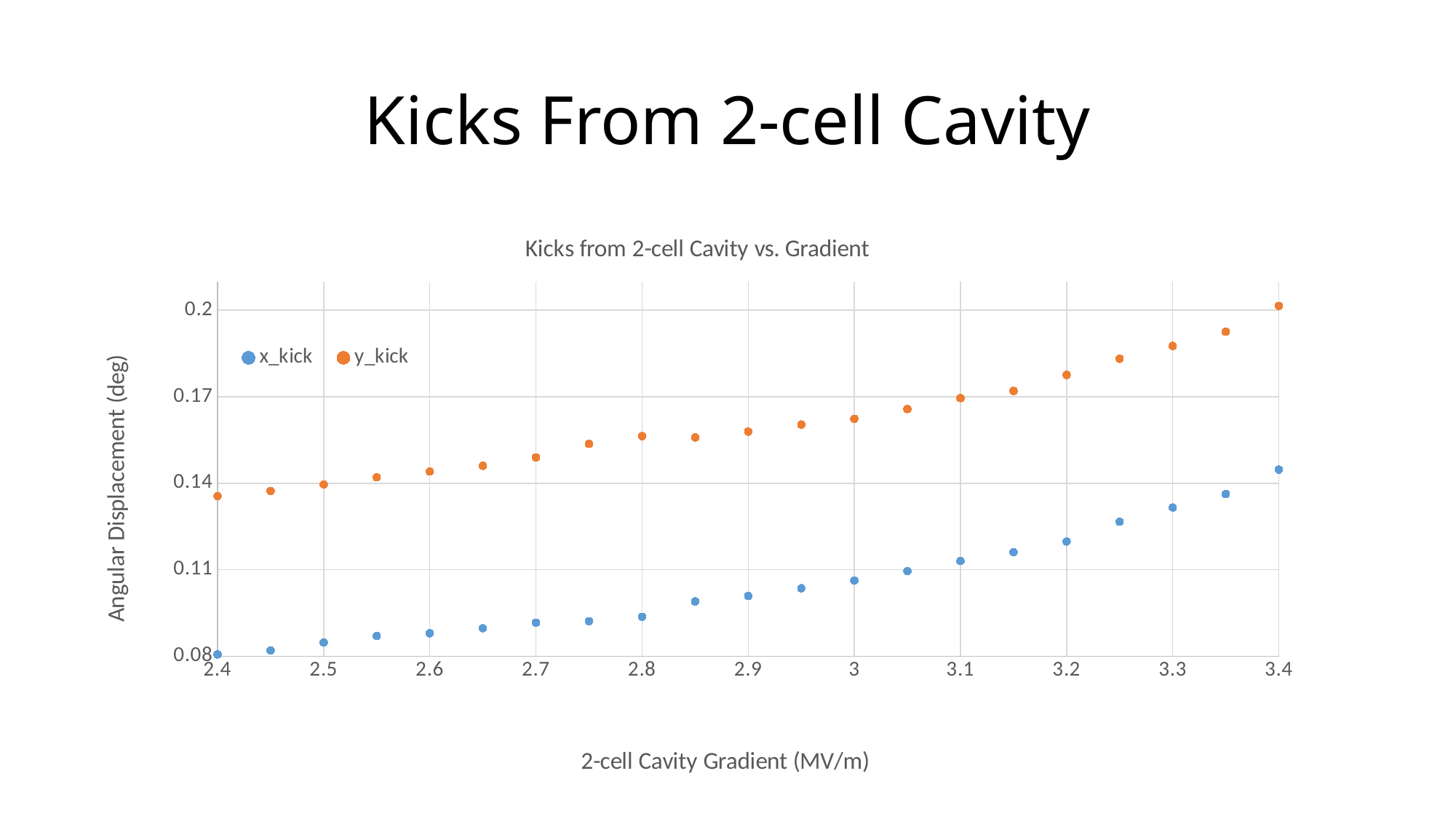
Is the y_kick value at a gradient of 2.4 MV/m greater or less than 0.14? less How many data points are plotted for the x_kick series? 21 Do the x_kick values rise or fall as the gradient increases along the x axis? rise What kind of chart is shown on the slide? scatter chart What is the label of the y axis? Angular Displacement (deg) Is the x_kick value at a gradient of 3.4 MV/m greater or less than 0.14? greater Is the x_kick value at a gradient of 3 MV/m greater or less than 0.11? less Do the y_kick values rise or fall as the 2-cell cavity gradient increases from 2.4 to 3.4 MV/m? rise At a gradient of 3 MV/m, which series has the larger angular displacement, x_kick or y_kick? y_kick How many series does the chart legend list? 2 What are the names of the two series in the legend? x_kick and y_kick